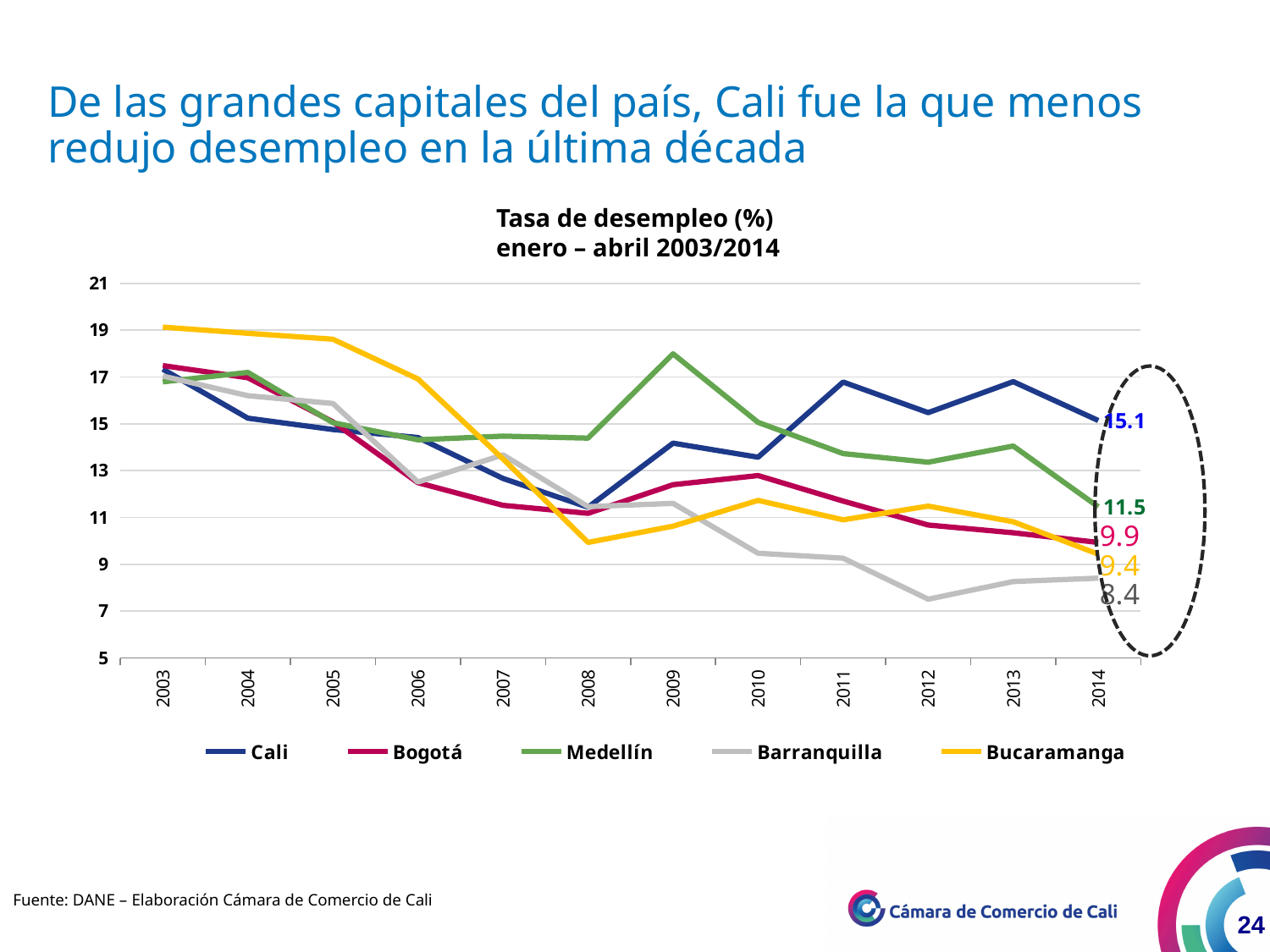
Is the value for Bucaramanga in 2003 greater or less than 17? greater Which city has the highest unemployment rate in 2014? Cali What kind of chart is shown on the slide? Line chart What is the unemployment rate for Medellín in 2014? 11.5 How many years are shown on the x axis? 12 In 2014, which city has the higher unemployment rate, Bogotá or Bucaramanga? Bogotá What is the unemployment rate for Cali in 2014? 15.1 Which city has the lowest unemployment rate in 2014? Barranquilla Is the value for Barranquilla in 2012 greater or less than 9? less What is the unemployment rate for Barranquilla in 2014? 8.4 How many series does the legend list? 5 What is the difference between the 2014 unemployment rates of Cali and Barranquilla? 6.7